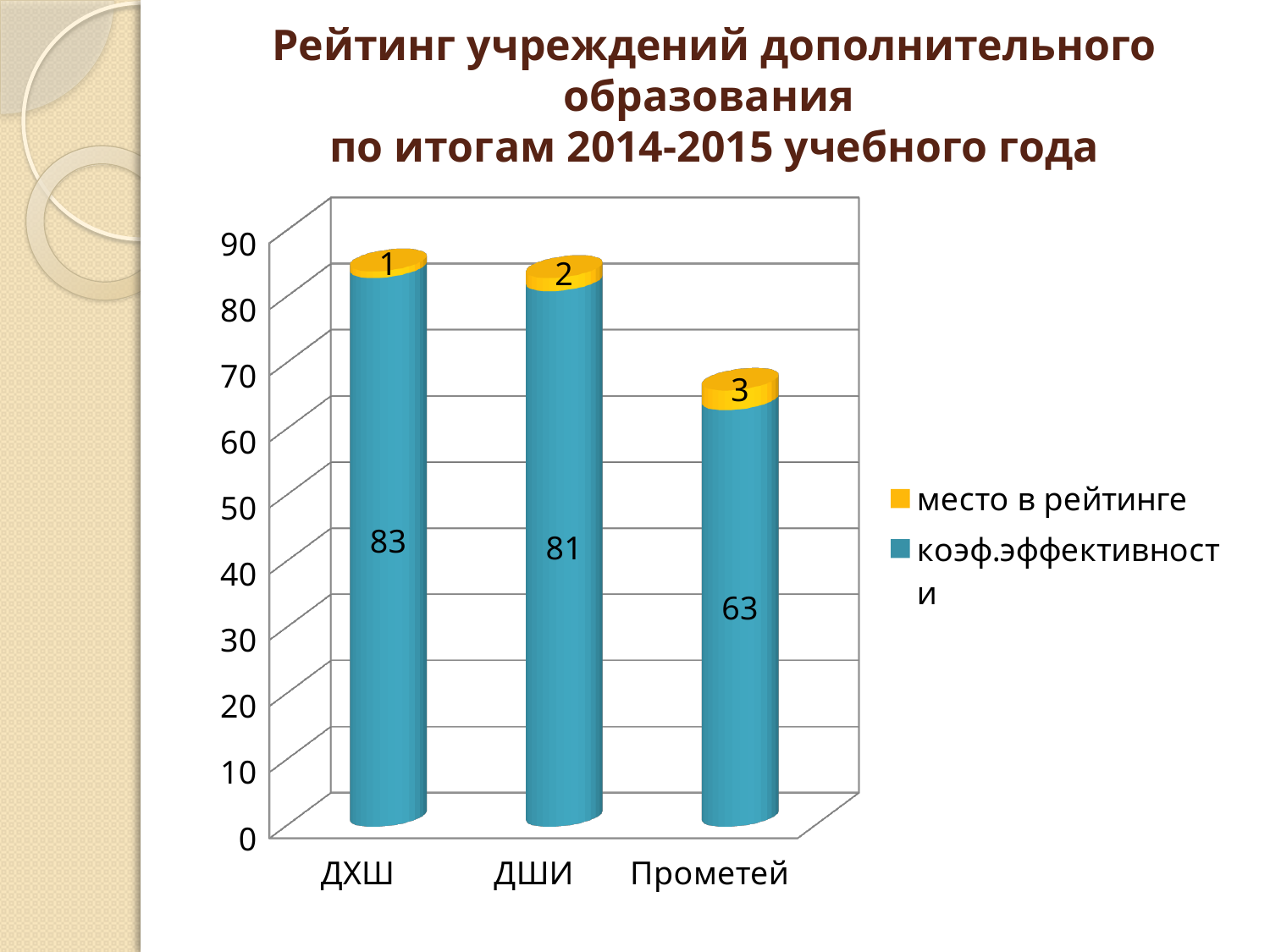
Which has a larger коэф.эффективности, ДШИ or Прометей? ДШИ Which category has the lowest коэф.эффективности? Прометей What is the difference between the коэф.эффективности values for ДХШ and Прометей? 20 How many series does the legend list? 2 What is the коэф.эффективности value for Прометей? 63 What is the место в рейтинге value for ДШИ? 2 What is the total of the stacked bar for ДШИ? 83 What kind of chart is shown on the slide? Bar chart How many categories are shown on the x axis? 3 Which category has the highest коэф.эффективности? ДХШ Which colour represents место в рейтинге in the legend? Yellow What is the коэф.эффективности value for ДХШ? 83